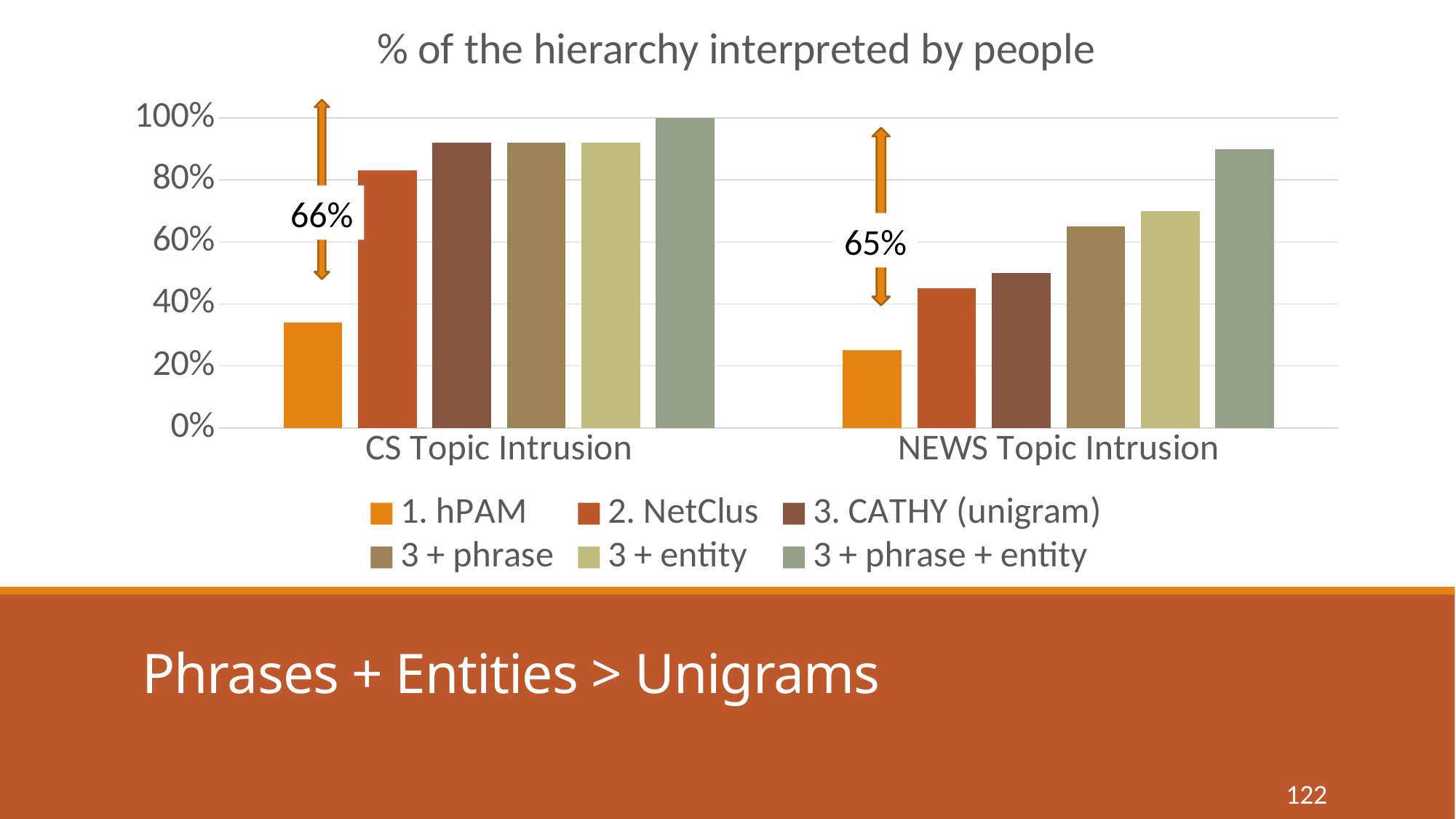
What kind of chart is shown on the slide? bar chart How many categories are shown on the x axis of the chart? 2 Which series has the lowest value in the NEWS Topic Intrusion category? 1. hPAM Which series has the lowest value in the CS Topic Intrusion category? 1. hPAM Which series has the highest value in the NEWS Topic Intrusion category? 3 + phrase + entity Is the value for 1. hPAM in the CS Topic Intrusion category greater or less than 40%? less What is the value for 3 + phrase + entity in the CS Topic Intrusion category? 100% How many series does the legend list? 6 What is the title of the chart? % of the hierarchy interpreted by people Which is larger: the value for 1. hPAM in CS Topic Intrusion or in NEWS Topic Intrusion? CS Topic Intrusion Which series has the highest value in the CS Topic Intrusion category? 3 + phrase + entity Is the value for 2. NetClus in the NEWS Topic Intrusion category greater or less than 60%? less